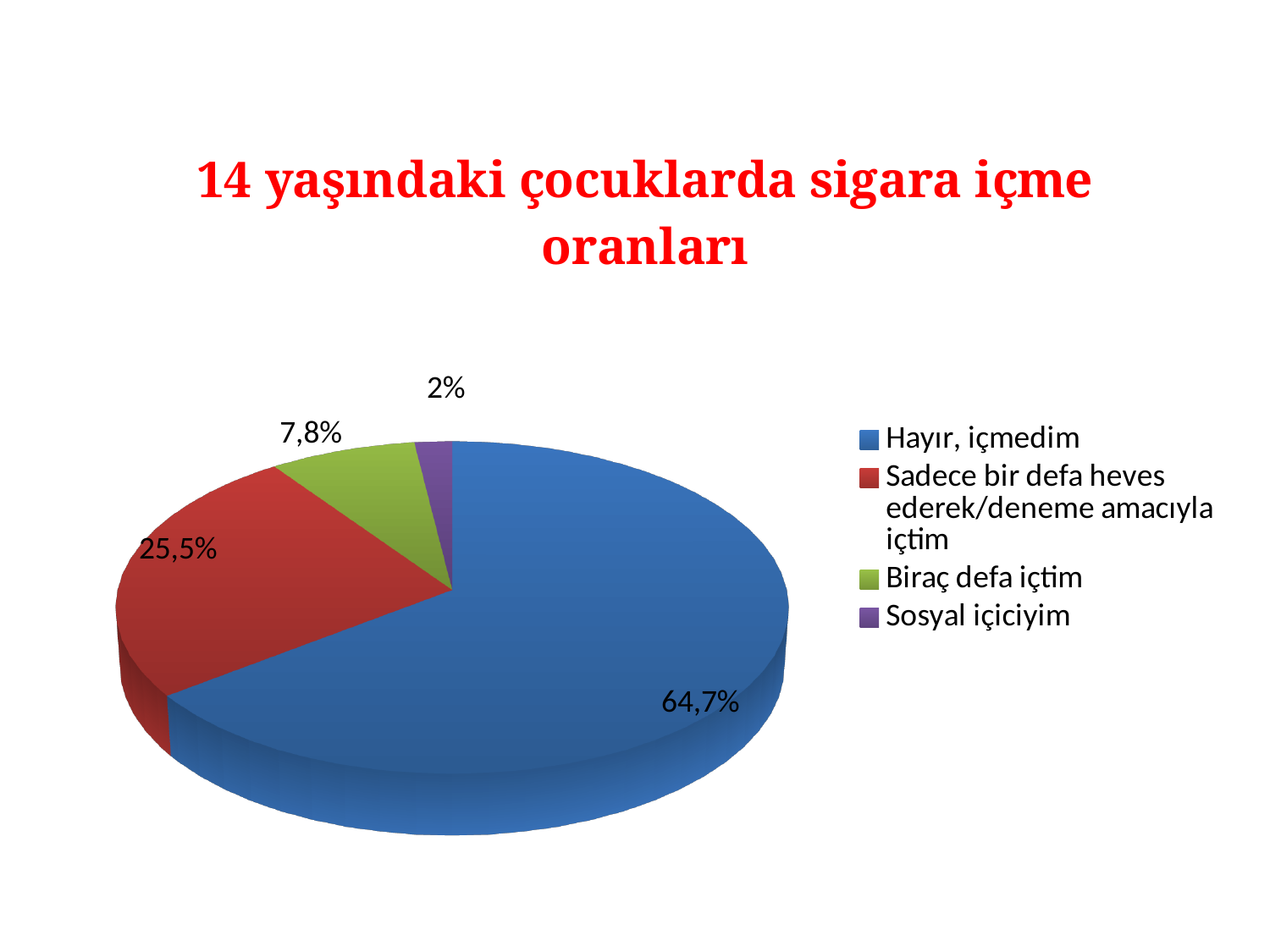
What is the value for "Sadece bir defa heves ederek/deneme amacıyla içtim"? 25,5% Which category has the smallest share of the pie? Sosyal içiciyim What kind of chart is shown on the slide? Pie chart What colour is the slice for "Biraç defa içtim"? Green Which category has the largest share of the pie? Hayır, içmedim What is the value for "Biraç defa içtim"? 7,8% Which is larger: the value for "Biraç defa içtim" or the value for "Sosyal içiciyim"? Biraç defa içtim What is the difference between the values for "Hayır, içmedim" and "Sadece bir defa heves ederek/deneme amacıyla içtim"? 39,2% What is the title of the chart? 14 yaşındaki çocuklarda sigara içme oranları How many categories does the pie chart have? 4 What is the value for "Sosyal içiciyim"? 2% What is the value for "Hayır, içmedim"? 64,7%